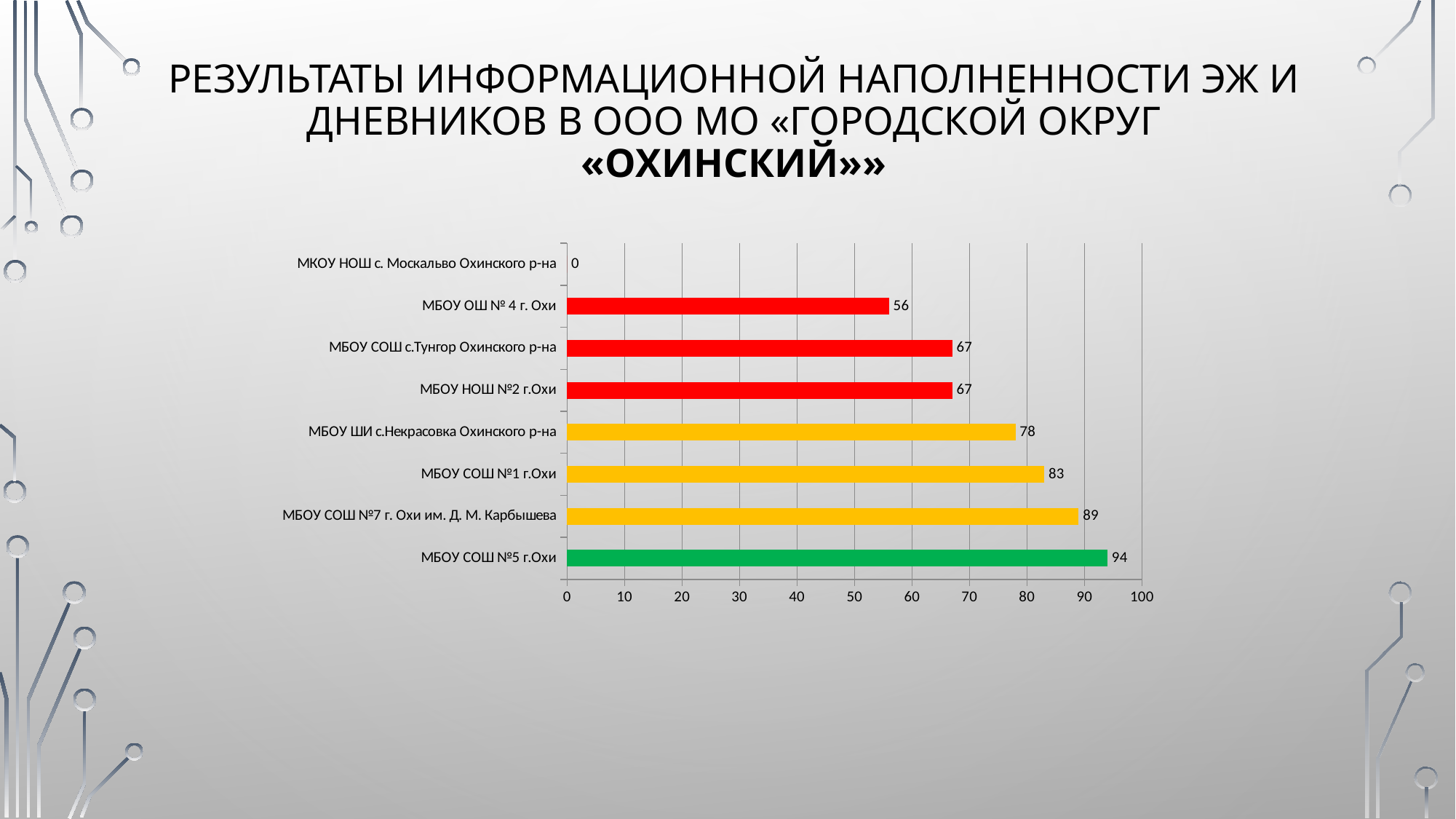
What is the value for МБОУ ОШ № 4 г. Охи? 56 What is the value for МБОУ ШИ с.Некрасовка Охинского р-на? 78 Which category has the highest value? МБОУ СОШ №5 г.Охи Which category has the lowest value? МКОУ НОШ с. Москальво Охинского р-на What kind of chart is shown on the slide? bar chart What is the difference between the values for МБОУ СОШ №5 г.Охи and МБОУ СОШ №7 г. Охи им. Д. М. Карбышева? 5 Which is larger, the value for МБОУ СОШ №1 г.Охи or the value for МБОУ ШИ с.Некрасовка Охинского р-на? МБОУ СОШ №1 г.Охи Is the value for МБОУ НОШ №2 г.Охи greater or less than 60? greater What colour is the bar for МБОУ СОШ №5 г.Охи? green How many categories are shown in the chart? 8 What is the difference between the values for МБОУ СОШ №1 г.Охи and МБОУ ОШ № 4 г. Охи? 27 What is the value for МБОУ СОШ №5 г.Охи? 94